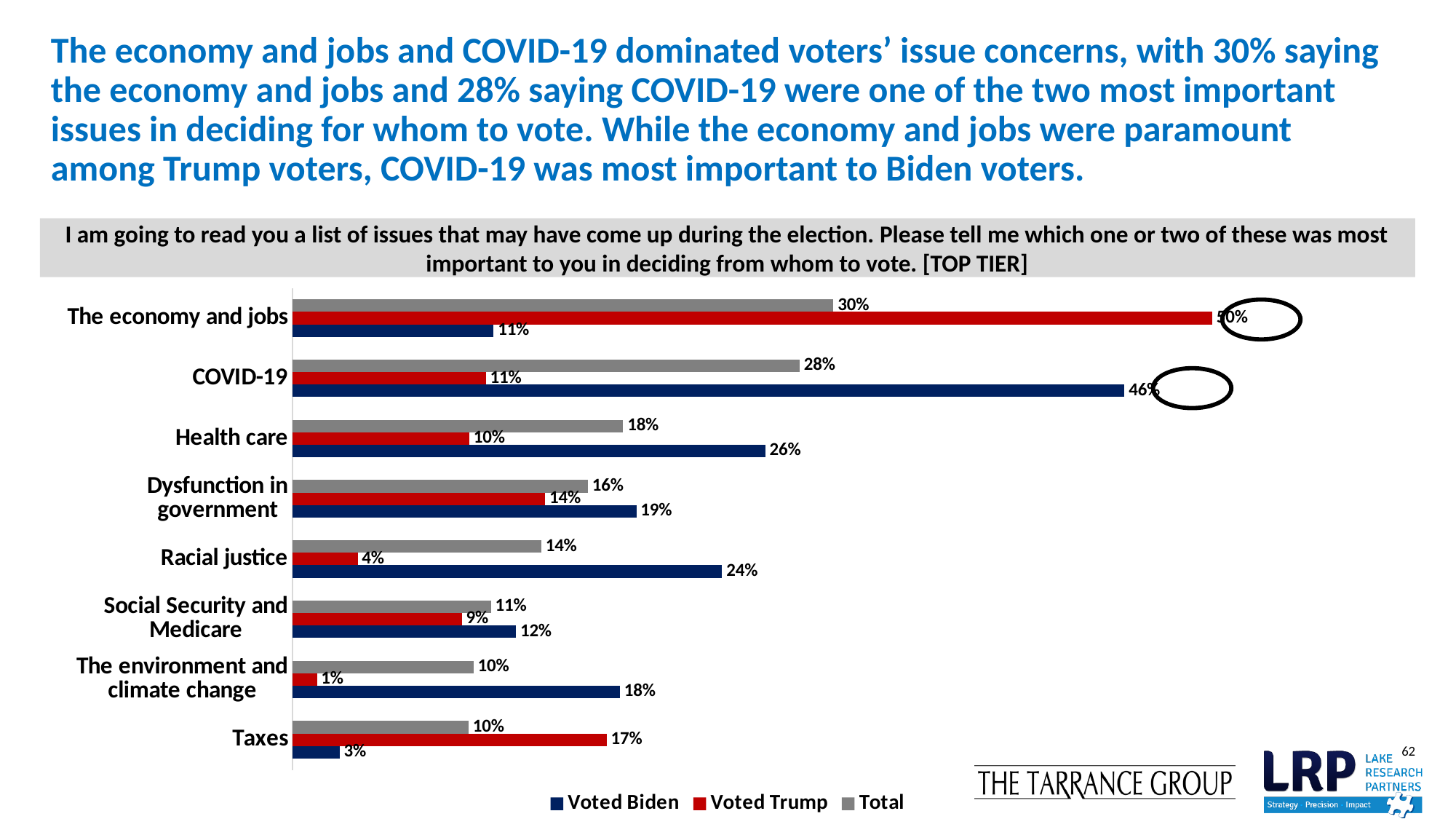
How many series does the legend list? 3 What is the Voted Trump value for Racial justice? 4% What percentage of Trump voters named the economy and jobs as a most important issue? 50% What is the Total value for Health care? 18% What percentage of Biden voters named COVID-19 as a most important issue? 46% How many issues are listed on the chart? 8 Which issue has the highest Voted Biden value? COVID-19 For Dysfunction in government, which is larger: the Voted Biden value or the Voted Trump value? Voted Biden Which colour represents the Voted Trump series? Red What is the difference between the Voted Biden and Voted Trump values for Taxes? 14% What kind of chart is shown on the slide? Bar chart Which issue has the lowest Voted Trump value? The environment and climate change